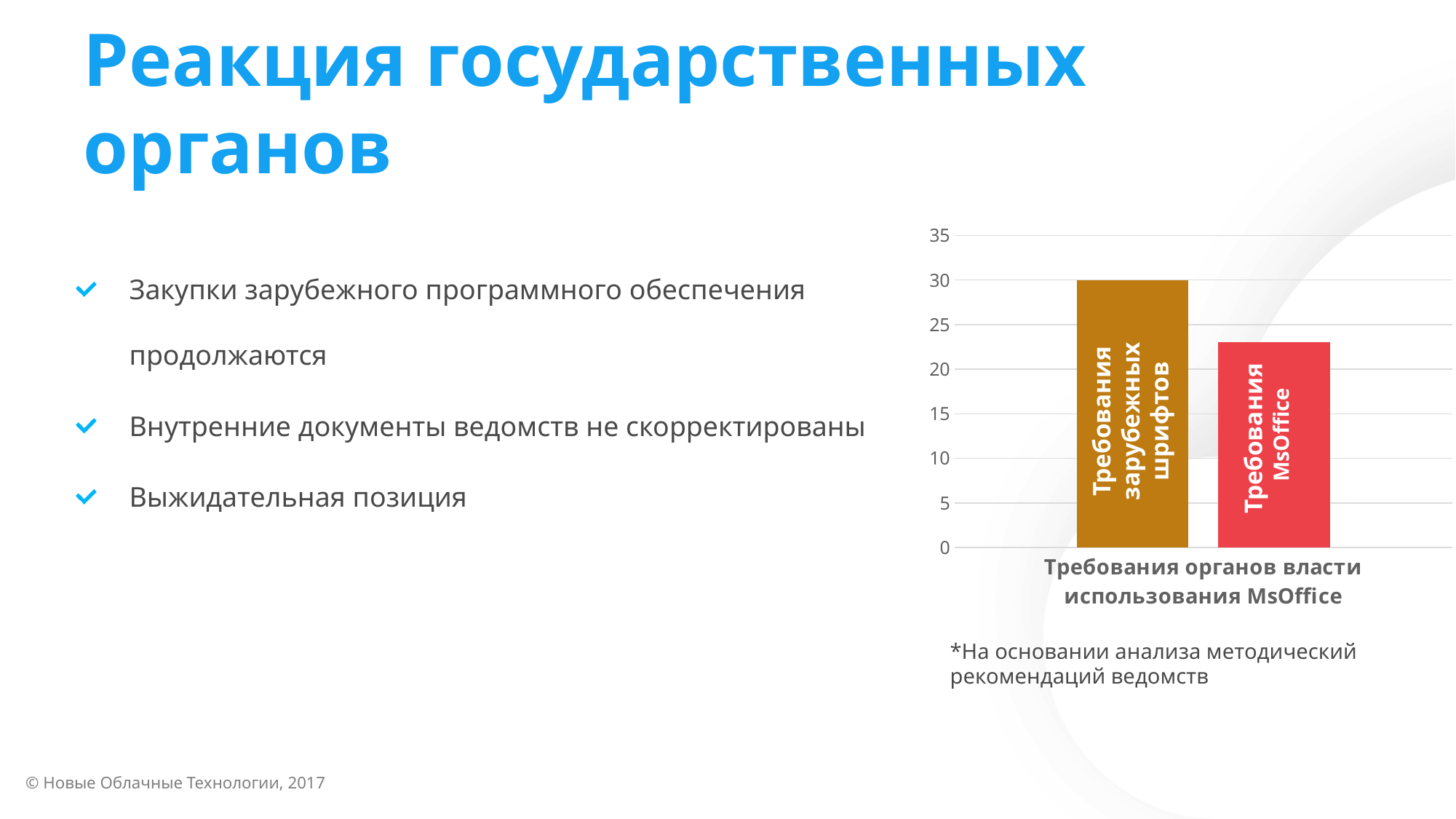
Is the value for 'Требования MsOffice' greater or less than 20? greater What is the value of the bar labelled 'Требования зарубежных шрифтов'? 30 Which is larger: the bar for 'Требования зарубежных шрифтов' or the bar for 'Требования MsOffice'? Требования зарубежных шрифтов What is the highest value shown on the vertical axis of the chart? 35 Which bar is the shortest in the chart? Требования MsOffice Is the value for 'Требования зарубежных шрифтов' greater or less than 25? greater Is the value for 'Требования MsOffice' greater or less than 25? less What kind of chart is shown on the slide? bar chart Which bar is the tallest in the chart? Требования зарубежных шрифтов How many bars are plotted in the chart? 2 What is the category label printed below the bars on the horizontal axis? Требования органов власти использования MsOffice